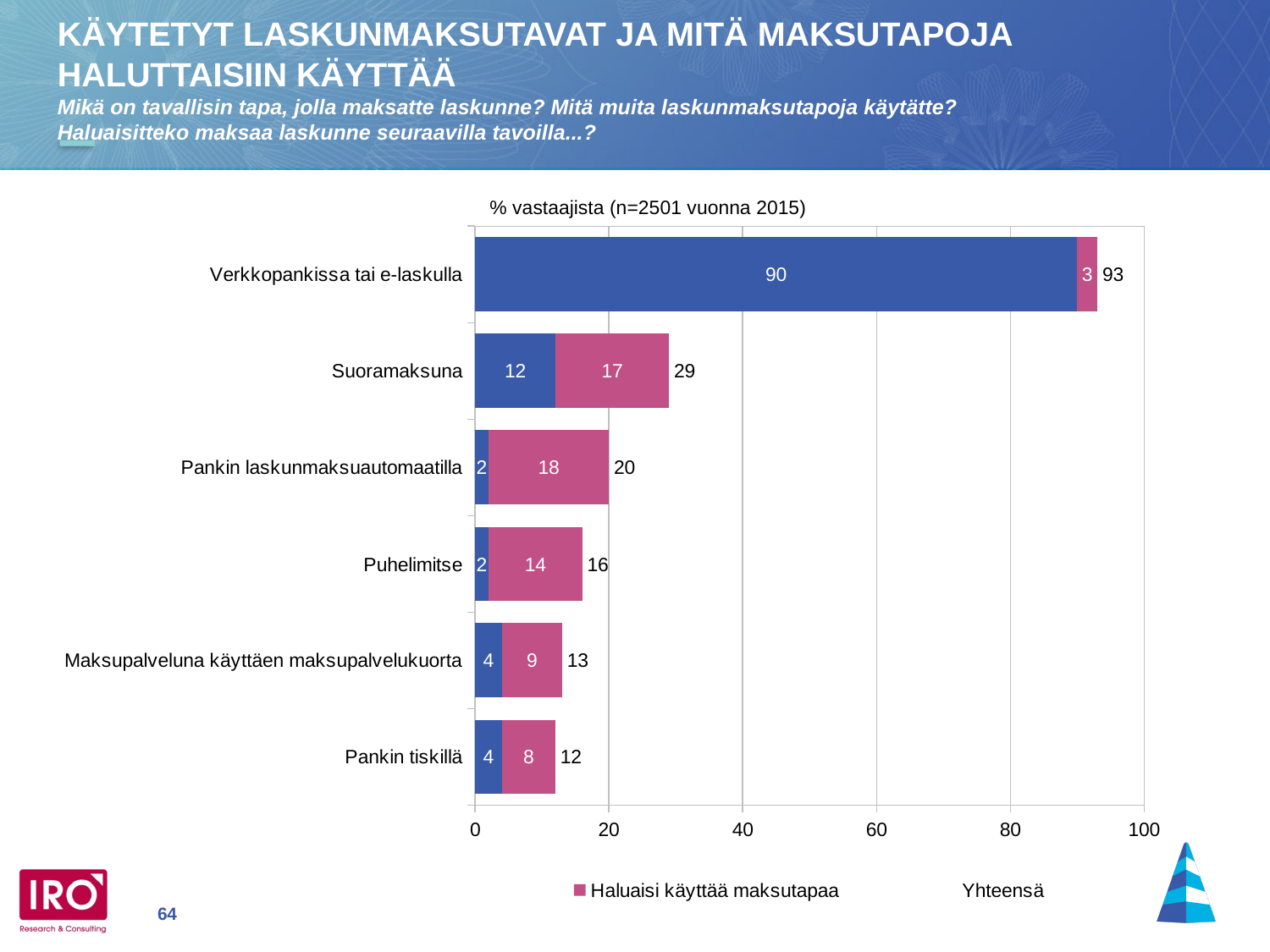
What is the total value shown for Verkkopankissa tai e-laskulla? 93 What is the 'Haluaisi käyttää maksutapaa' value for Suoramaksuna? 17 What kind of chart is shown on the slide? Stacked bar chart Which category has the lowest total value? Pankin tiskillä What is the total value shown for Pankin tiskillä? 12 Which has a larger 'Haluaisi käyttää maksutapaa' value, Puhelimitse or Maksupalveluna käyttäen maksupalvelukuorta? Puhelimitse How many categories are shown in the chart? 6 What is the subtitle printed above the chart? % vastaajista (n=2501 vuonna 2015) Is the total value for Suoramaksuna greater or less than 20? greater Which category has the highest total value? Verkkopankissa tai e-laskulla What is the difference between the total values for Suoramaksuna and Pankin laskunmaksuautomaatilla? 9 What is the 'Haluaisi käyttää maksutapaa' value for Pankin laskunmaksuautomaatilla? 18